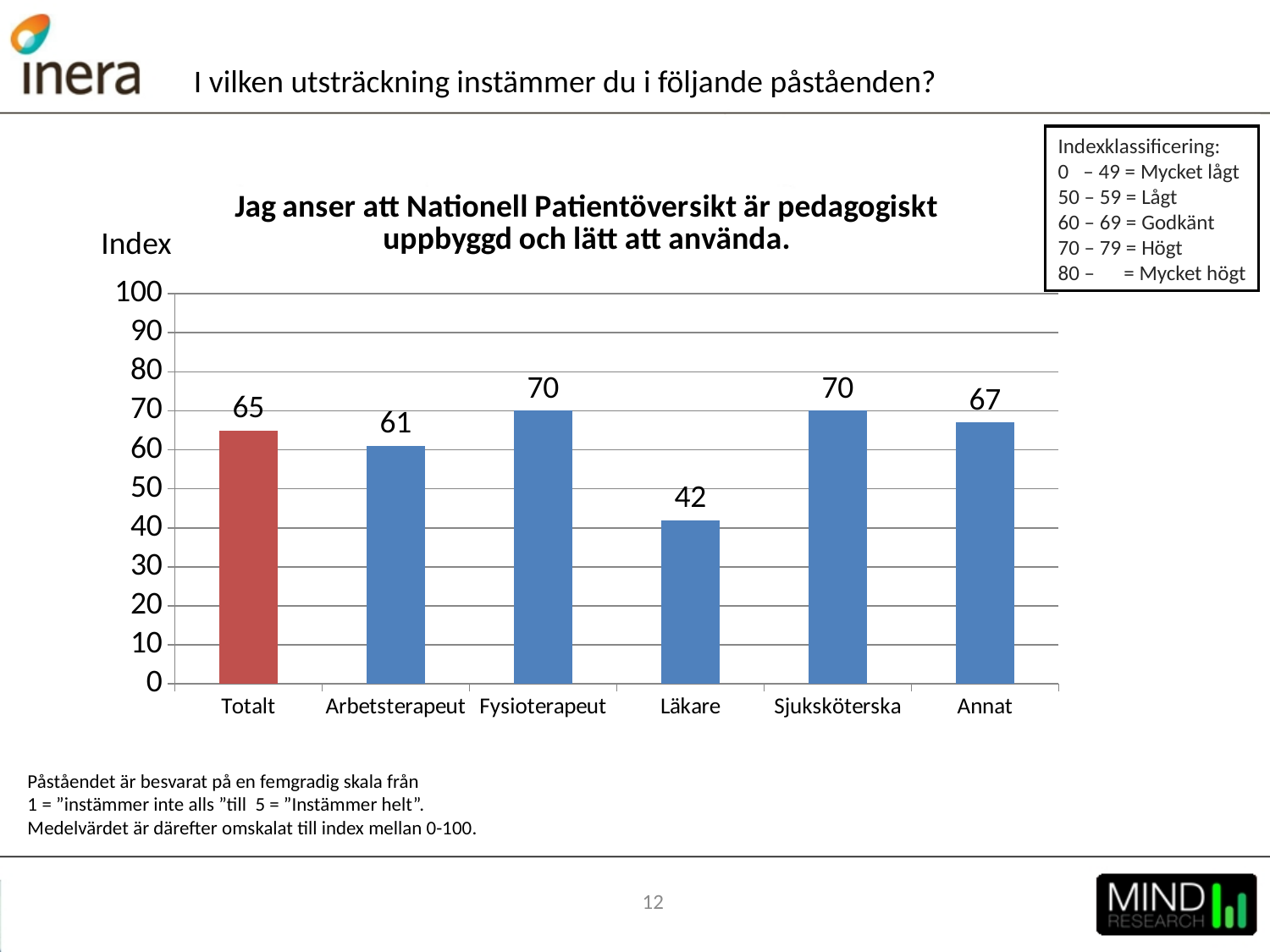
What is the index value for Läkare? 42 Which is larger, the index value for Annat or for Arbetsterapeut? Annat Is the index value for Läkare greater or less than 50? less What kind of chart is shown on the slide? bar chart What is the difference between the index values for Totalt and Arbetsterapeut? 4 What is the difference between the index values for Sjuksköterska and Läkare? 28 What is the index value for Annat? 67 Which bar is shown in a different colour (red) from the others? Totalt What is the index value for Arbetsterapeut? 61 What is the index value for Totalt? 65 Which category has the lowest index value? Läkare How many categories are shown on the x axis? 6